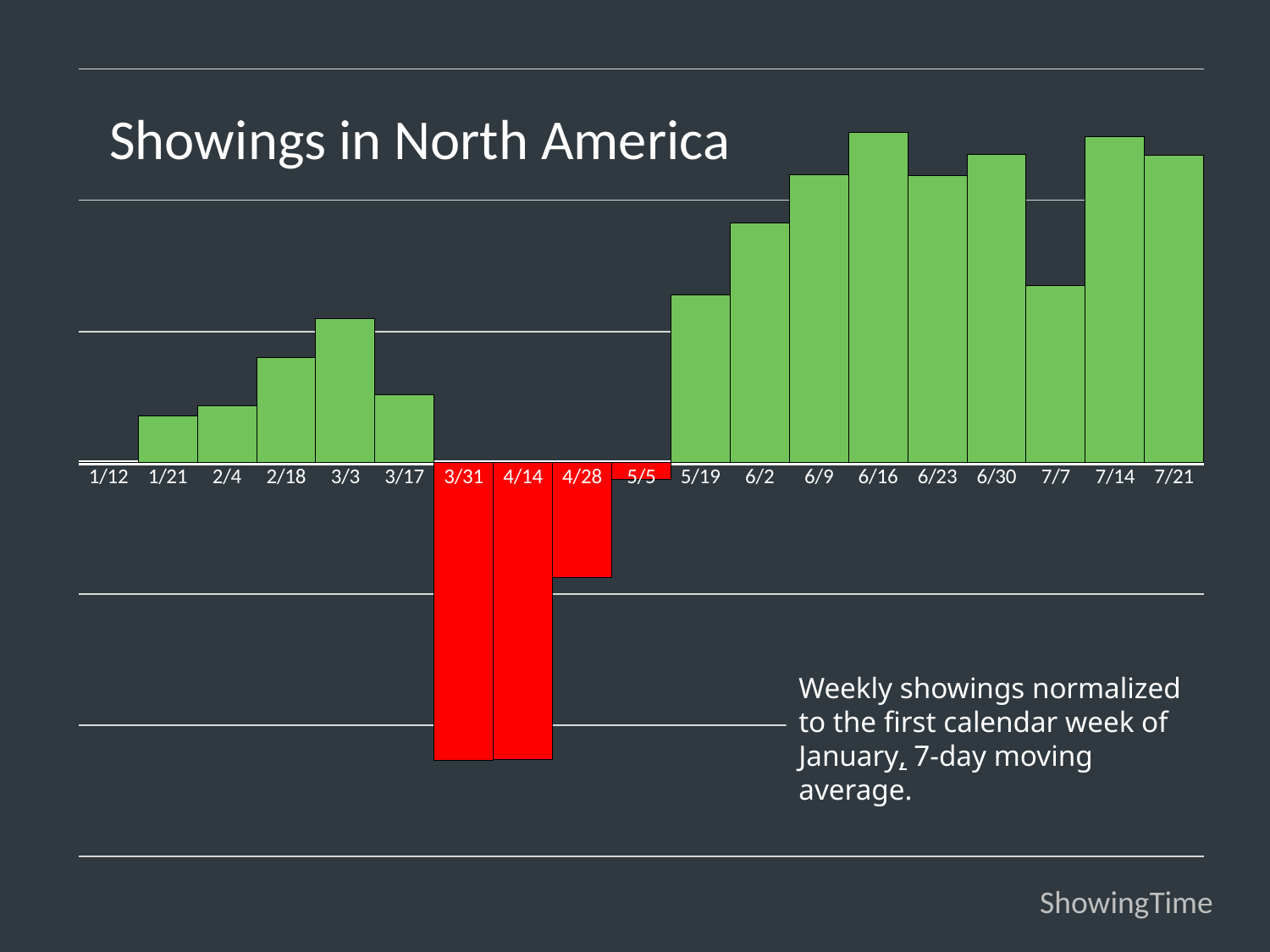
Which is larger, the value for 4/28 or the value for 5/5? 5/5 Do the values rise or fall from 1/21 to 3/3? Rise What is the title of the chart? Showings in North America Which is larger, the value for 6/9 or the value for 7/7? 6/9 Do the values rise or fall from 5/19 to 6/16? Rise How many date labels are shown along the x axis? 19 How many bars are shown in red (below the zero line)? 4 Do the values rise or fall from 3/3 to 3/17? Fall Which is larger, the value for 3/3 or the value for 3/17? 3/3 What kind of chart is shown on the slide? Bar chart Which dates have red bars extending below the zero line? 3/31, 4/14, 4/28, 5/5